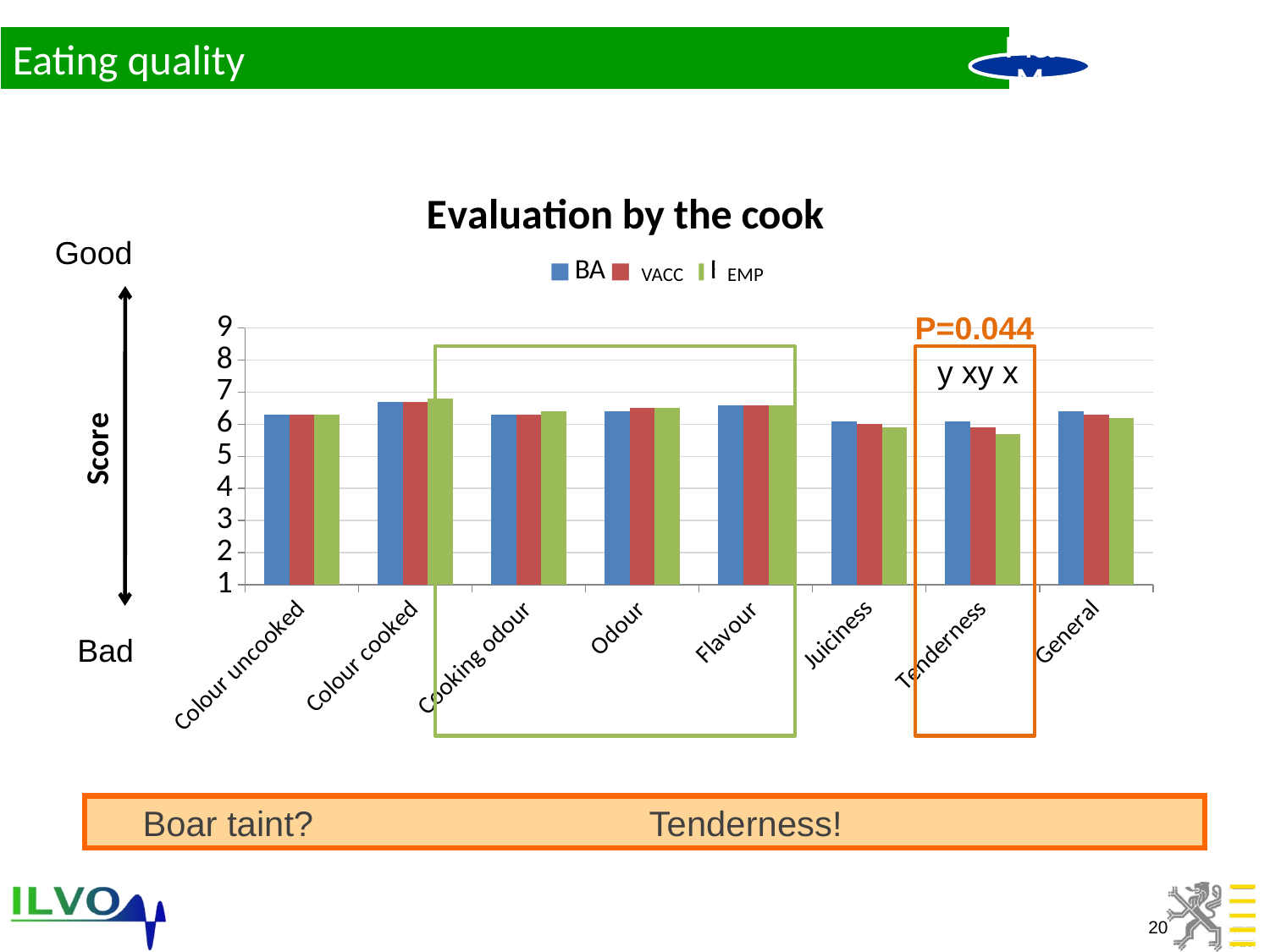
What is the title of the chart? Evaluation by the cook How many categories are shown on the x axis of the chart? 8 For the BA series, which is larger, Colour uncooked or Colour cooked? Colour cooked Which is larger, the BA value for Juiciness or the EMP value for Tenderness? BA value for Juiciness What kind of chart is shown on the slide? bar chart How many series does the chart's legend list? 3 For Tenderness, which series has the larger value, BA or EMP? BA Which category on the chart is annotated with P=0.044? Tenderness Is the EMP value for Juiciness greater or less than 5? greater Is the VACC value for Flavour greater or less than 6? greater Is the EMP value for Colour cooked greater or less than 8? less